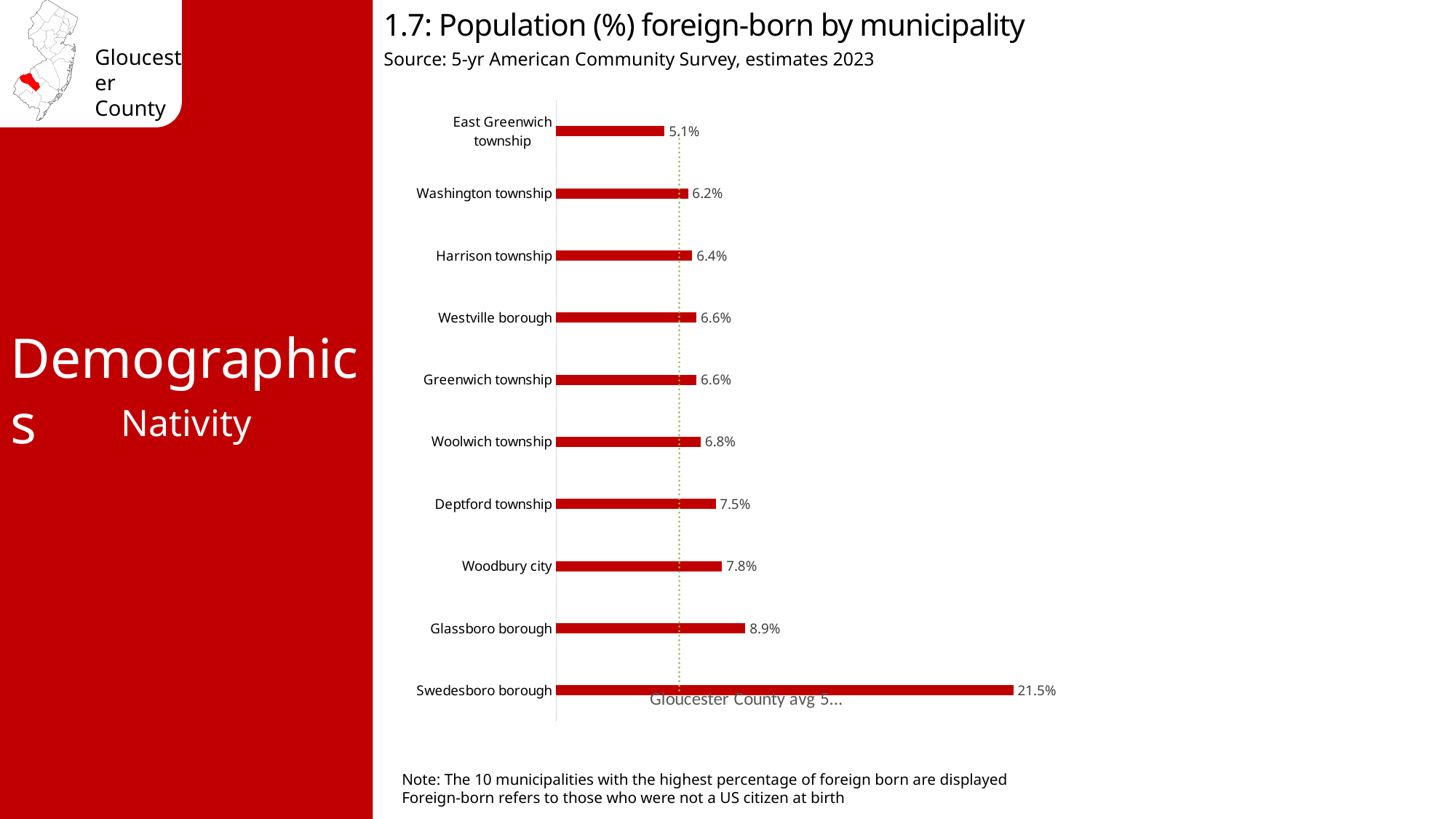
Which has a higher foreign-born percentage, Woolwich township or Harrison township? Woolwich township Which municipality has the lowest percentage of foreign-born population? East Greenwich township What is the percentage of foreign-born population for Glassboro borough? 8.9% How many municipalities are shown in the chart? 10 Which municipality has the highest percentage of foreign-born population? Swedesboro borough What is the percentage of foreign-born population for Deptford township? 7.5% What is the title of the chart? 1.7: Population (%) foreign-born by municipality What is the difference in foreign-born percentage between Woodbury city and Washington township? 1.6% What is the difference in foreign-born percentage between Swedesboro borough and Glassboro borough? 12.6% What type of chart is used on this slide? Bar chart What is the percentage of foreign-born population for East Greenwich township? 5.1% What is the percentage of foreign-born population for Swedesboro borough? 21.5%